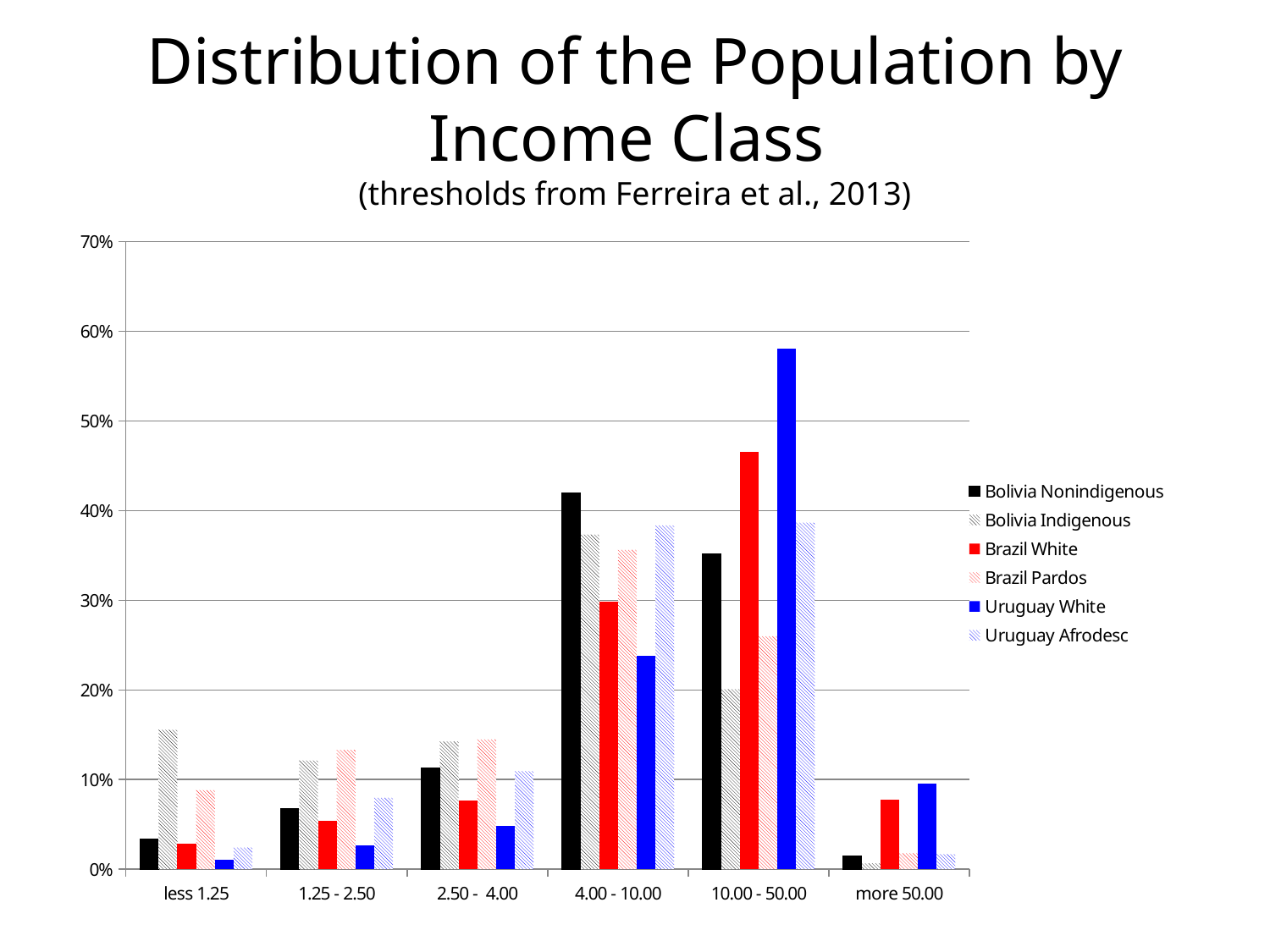
In the 10.00 - 50.00 income class, which series has the highest bar? Uruguay White How many series does the legend list? 6 In which income class does Bolivia Nonindigenous have its highest bar? 4.00 - 10.00 According to the subtitle, where do the income thresholds come from? Ferreira et al., 2013 In the less 1.25 income class, which is larger: Bolivia Indigenous or Brazil Pardos? Bolivia Indigenous In which income class does Uruguay White have its highest bar? 10.00 - 50.00 Is the value for Brazil White in the 10.00 - 50.00 income class greater or less than 40%? greater What kind of chart is shown on the slide? bar chart Is the value for Bolivia Nonindigenous in the 4.00 - 10.00 income class greater or less than 40%? greater Is the value for Uruguay White in the 10.00 - 50.00 income class greater or less than 50%? greater In the 10.00 - 50.00 income class, which series has the lowest bar? Bolivia Indigenous How many income classes are shown on the x axis? 6